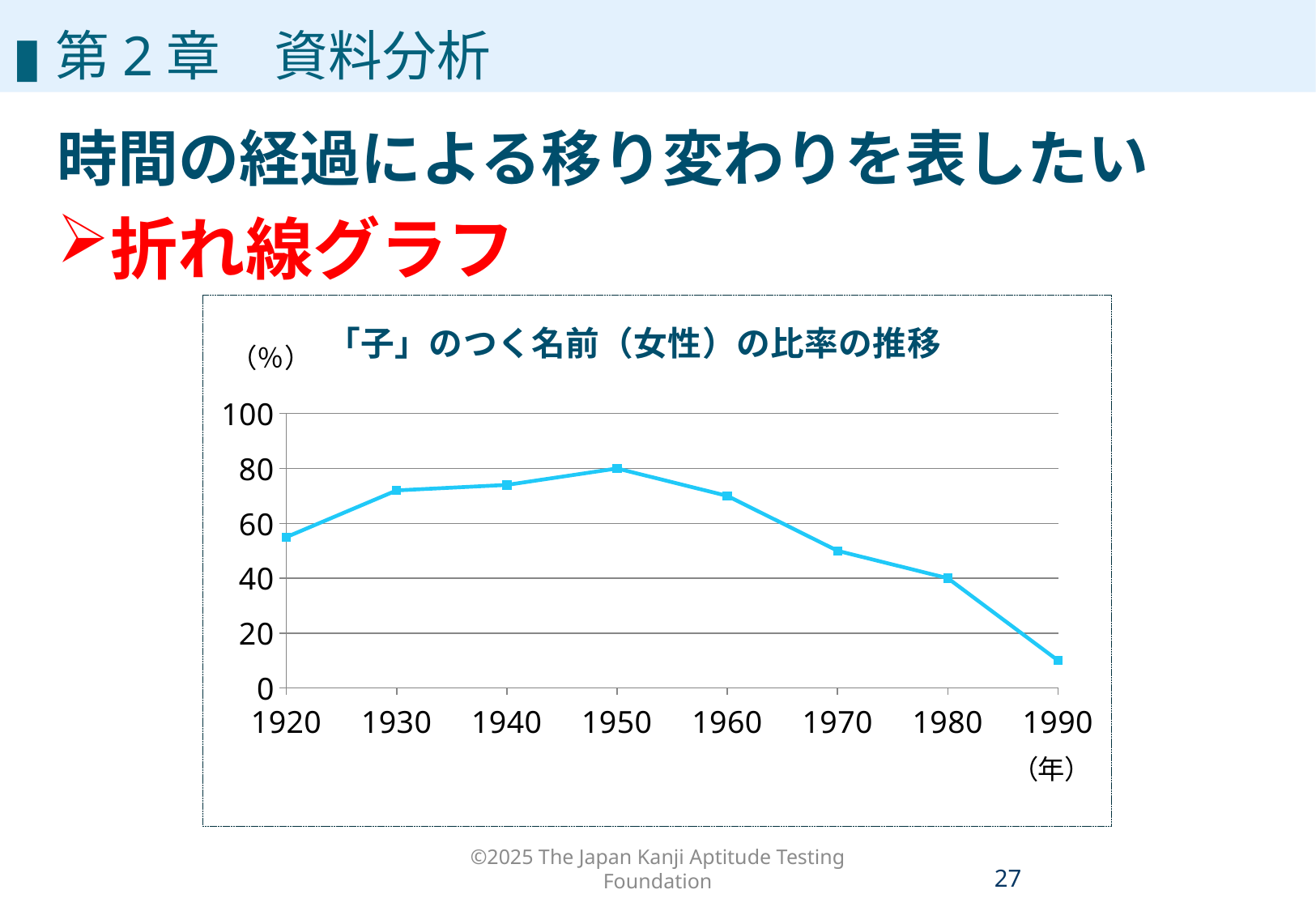
What is the value for 1980? 40 Do the values rise or fall from 1950 to 1990? fall What is the title of the chart? 「子」のつく名前（女性）の比率の推移 Is the value for 1990 greater or less than 20? less Which year has the highest value? 1950 What is the value for 1950? 80 What kind of chart is shown on the slide? line chart Which year has the lowest value? 1990 Is the value for 1920 greater or less than 40? greater What is the difference between the values for 1950 and 1980? 40 How many data points are plotted on the line? 8 Which is larger, the value for 1930 or the value for 1970? 1930